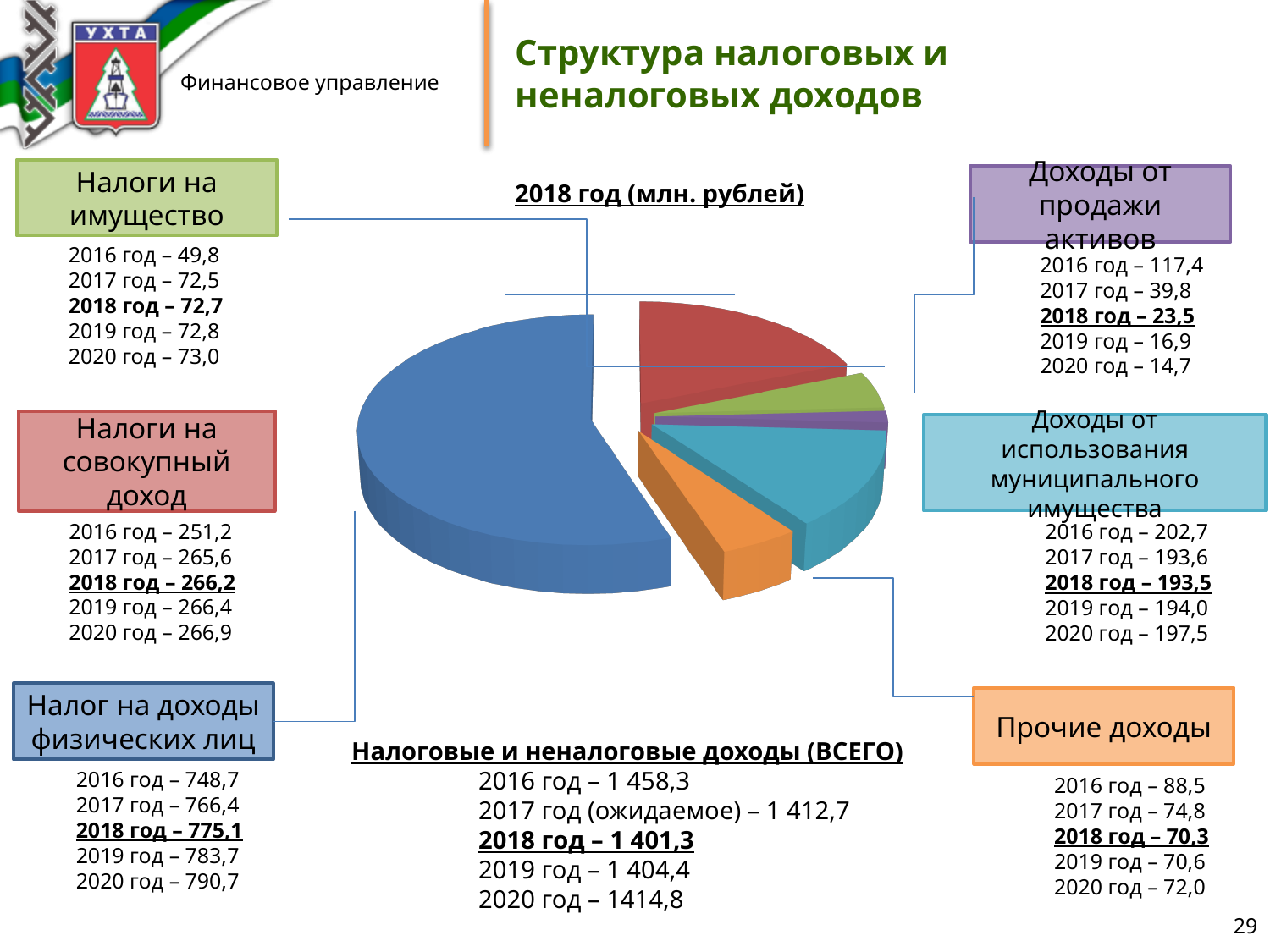
What is the 2018 value for Доходы от использования муниципального имущества shown for the pie chart? 193,5 Which category has the smallest slice of the pie chart? Доходы от продажи активов What colour is the largest slice of the pie chart? Blue What is the title of the pie chart? 2018 год (млн. рублей) Which slice is larger in the pie chart: Налоги на совокупный доход or Доходы от использования муниципального имущества? Налоги на совокупный доход Which category has the largest slice of the pie chart? Налог на доходы физических лиц What is the 2018 value for Налог на доходы физических лиц shown for the pie chart? 775,1 What is the difference between the 2018 values for Налог на доходы физических лиц and Налоги на совокупный доход? 508,9 How many slices does the pie chart have? 6 What is the 2018 value for Прочие доходы shown for the pie chart? 70,3 What kind of chart is shown on the slide? Pie chart What is the 2018 value for Налоги на совокупный доход shown for the pie chart? 266,2